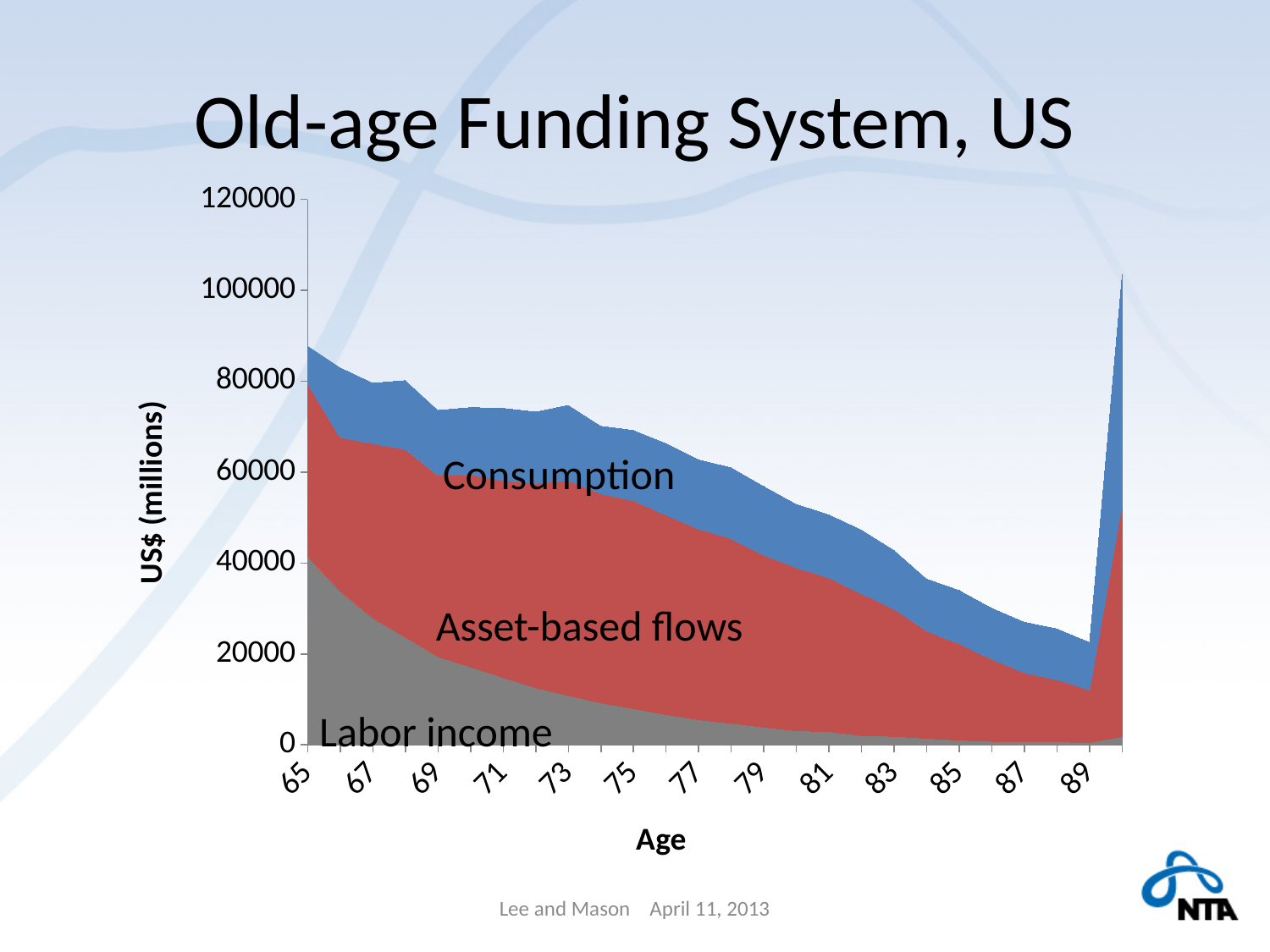
Is the total of all three series at age 89 greater or less than 20000? greater Which series forms the bottom layer of the stacked area? Labor income What is the label of the y axis? US$ (millions) What is the title of the chart? Old-age Funding System, US Is the value for Labor income at age 85 greater or less than 20000? less Is the total of all three series at age 65 greater or less than 80000? greater How many series are labeled in the chart? 3 How many age labels are shown on the x axis? 13 At age 85, which is larger: Consumption or Labor income? Consumption What kind of chart is shown on the slide? Stacked area chart At age 65, which is larger: Labor income or Consumption? Labor income Does Labor income rise or fall as age increases from 65 to 89? Fall